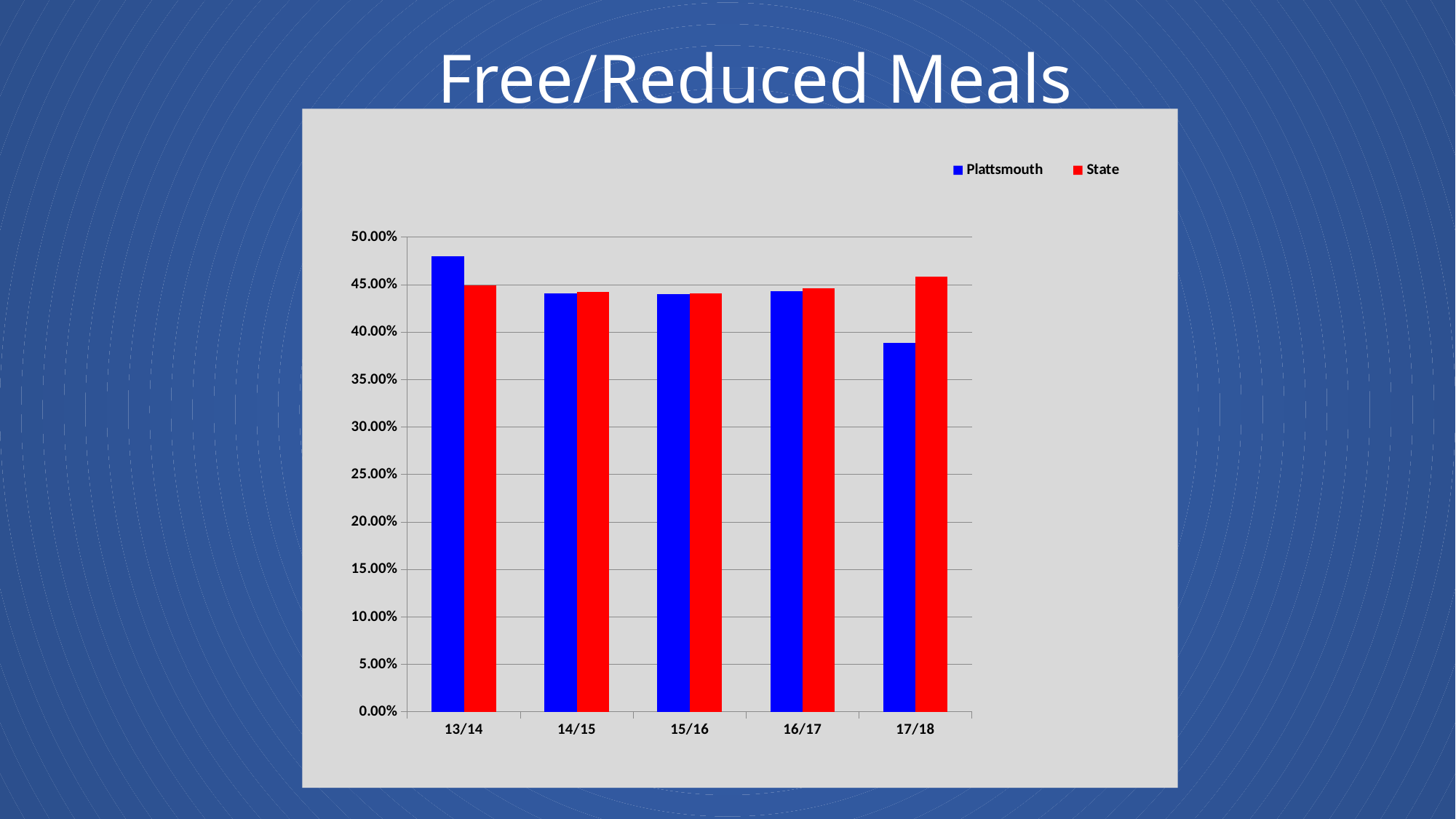
In which school year is the State value highest? 17/18 In 17/18, which is larger, the Plattsmouth value or the State value? State Is the Plattsmouth value for 13/14 greater or less than 45.00%? greater Which colour represents the State series? Red How many school years are shown on the x axis? 5 In 13/14, which is larger, the Plattsmouth value or the State value? Plattsmouth Is the Plattsmouth value for 17/18 greater or less than 40.00%? less How many series does the legend list? 2 What is the title of the chart? Free/Reduced Meals What kind of chart is shown on the slide? Bar chart In which school year is the Plattsmouth value highest? 13/14 In which school year is the Plattsmouth value lowest? 17/18